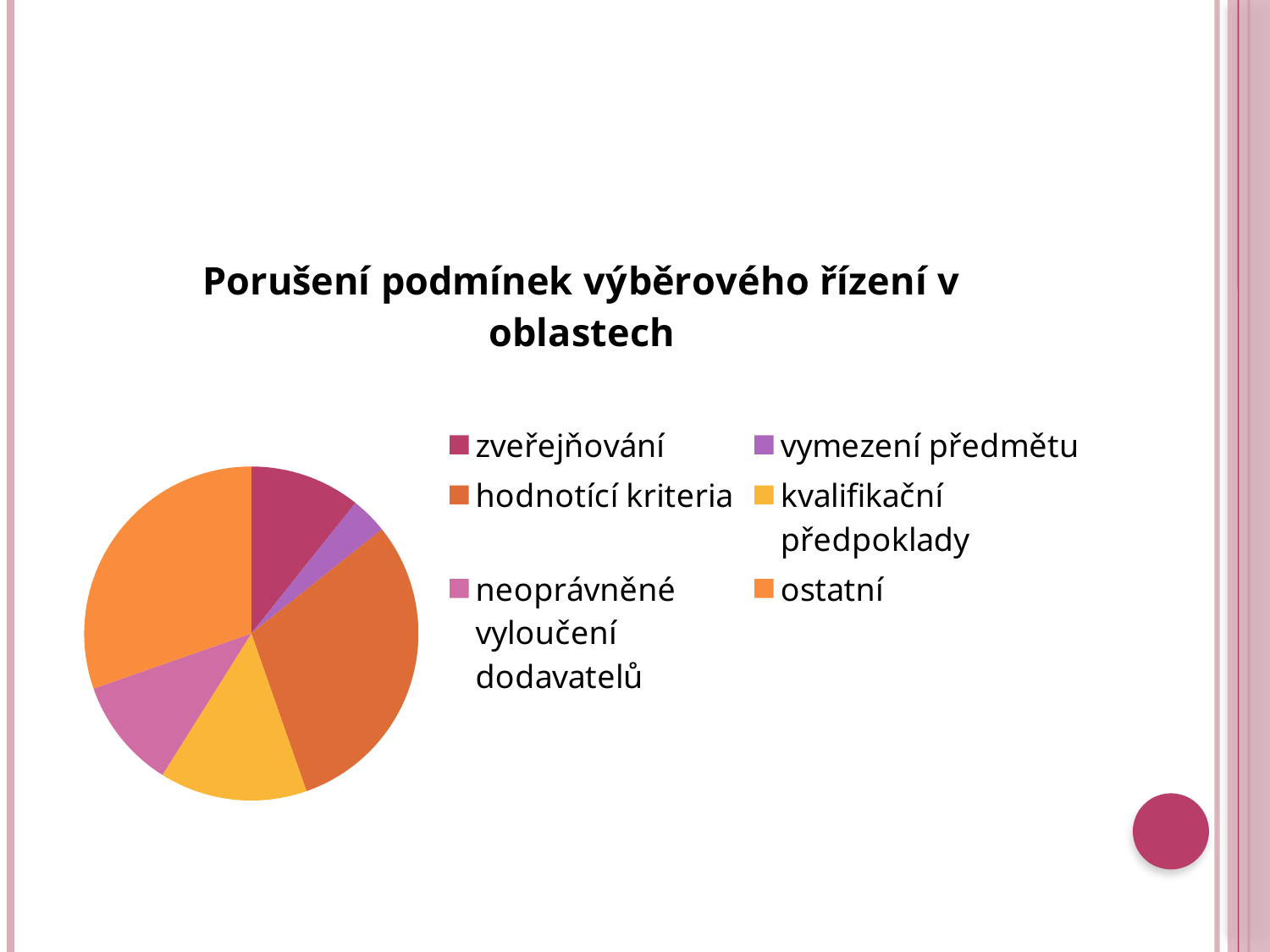
Which slice is larger: hodnotící kriteria or neoprávněné vyloučení dodavatelů? hodnotící kriteria Which category is shown in yellow in the pie chart? kvalifikační předpoklady Which slice is larger: zveřejňování or vymezení předmětu? zveřejňování How many slices does the pie chart have? 6 Which slice is larger: ostatní or zveřejňování? ostatní What kind of chart is shown on the slide? pie chart Which category has the smallest slice of the pie? vymezení předmětu How many entries does the legend list? 6 What is the title of the chart? Porušení podmínek výběrového řízení v oblastech